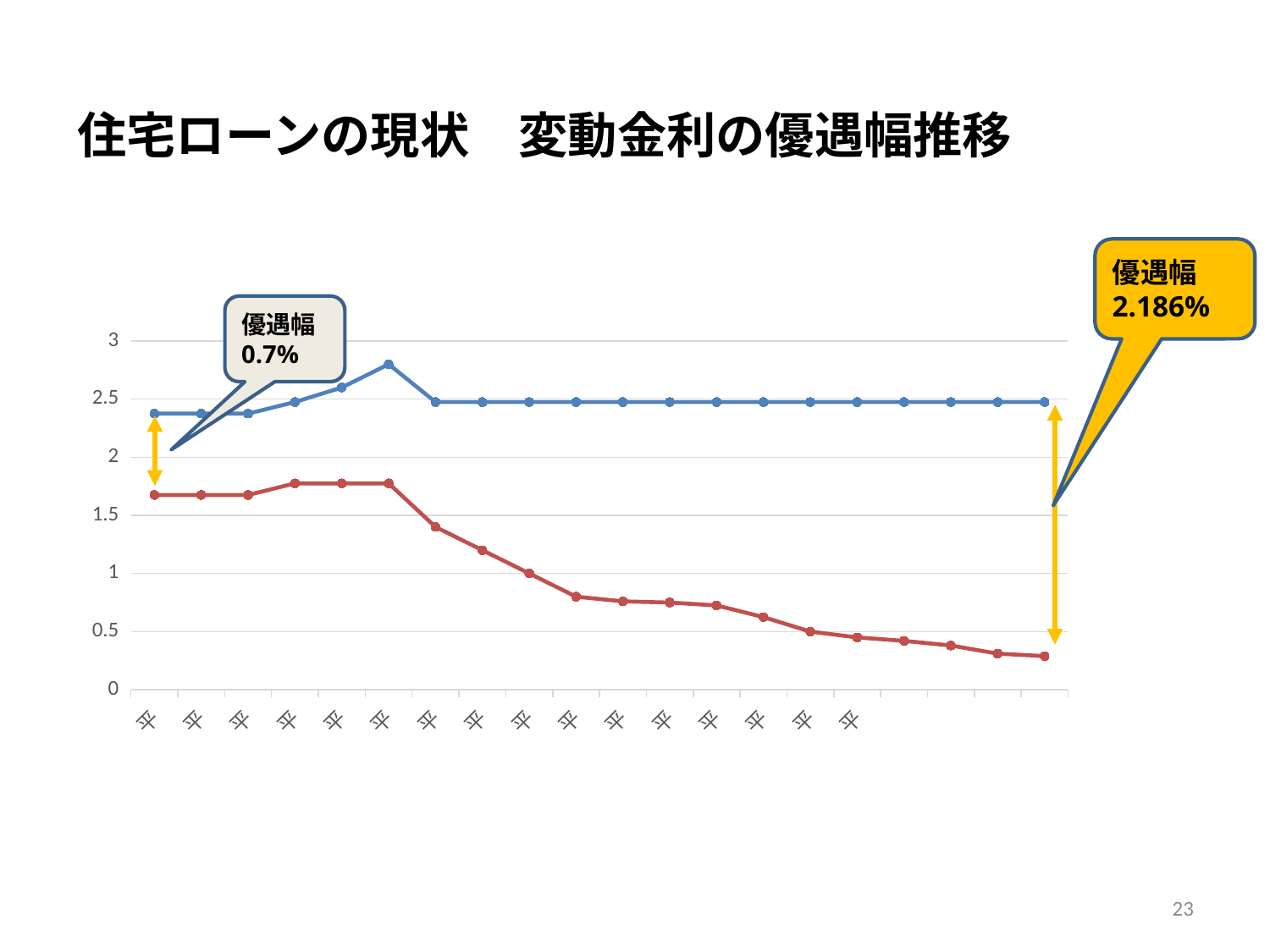
How many lines are plotted on the chart? 2 Does the gap between the blue and red lines widen or narrow from left to right? widen Is the value of the last point on the blue line greater or less than 2? greater Is the highest point of the blue line greater or less than 2.5? greater Which line is higher at the right end of the chart, the blue line or the red line? blue line Is the value of the last point on the red line greater or less than 0.5? less What is the title of the slide? 住宅ローンの現状 変動金利の優遇幅推移 Does the red line rise or fall from left to right across the chart? fall What 優遇幅 value is shown in the callout at the right (end) of the chart? 2.186% What 優遇幅 value is shown in the callout at the left (start) of the chart? 0.7% What kind of chart is shown on the slide? line chart